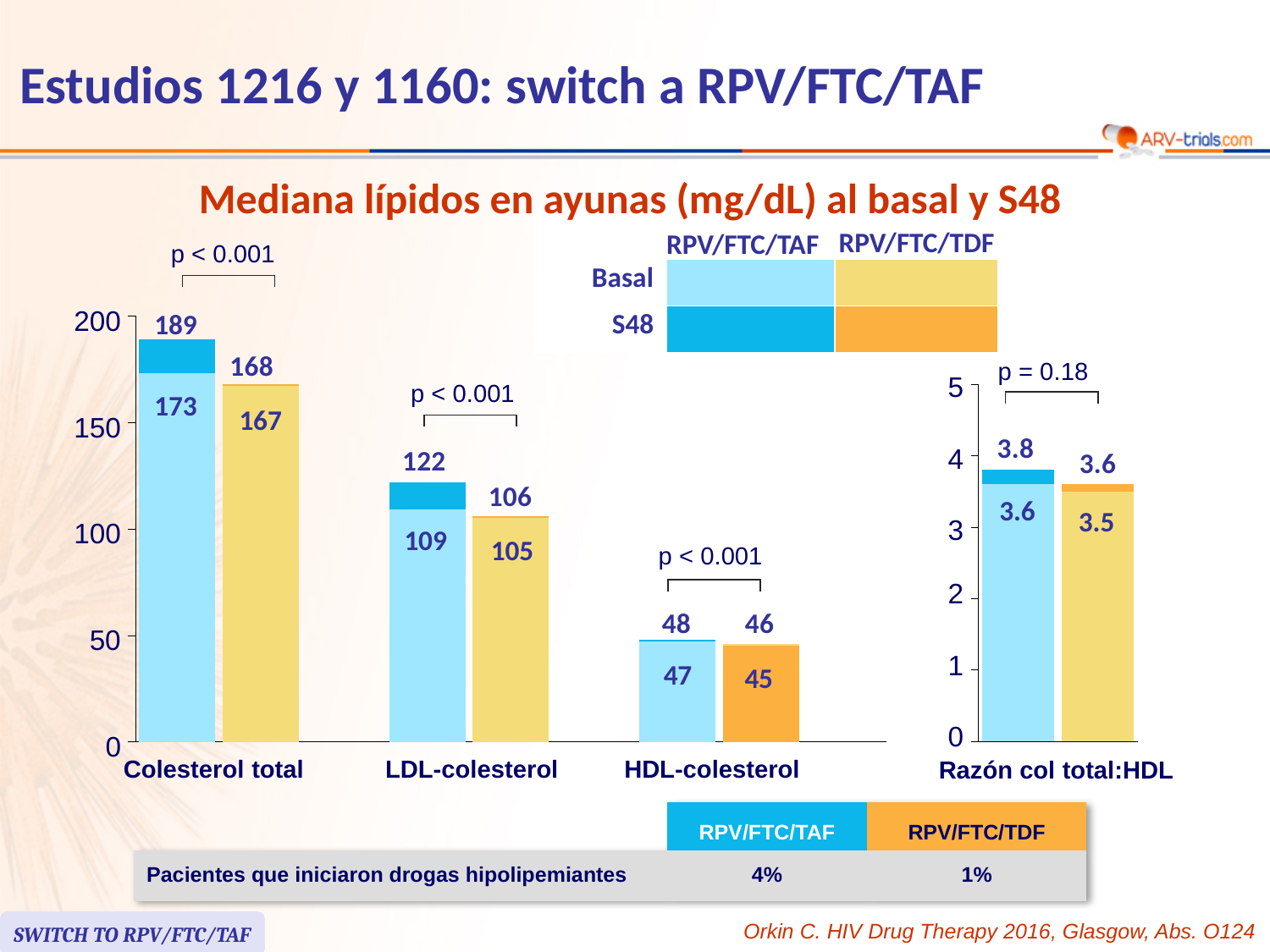
What type of chart is used to display the lipid values on this slide? Bar chart In the left chart, which group has the higher S48 total cholesterol, RPV/FTC/TAF or RPV/FTC/TDF? RPV/FTC/TAF In the left chart, by how much did median total cholesterol change from baseline (173) to S48 (189) in the RPV/FTC/TAF group? 16 In the left chart, how many lipid parameters (categories) are shown on the x axis? 3 In the left chart, which lipid parameter has the lowest values? HDL-colesterol In the left chart, what is the baseline (Basal) median total cholesterol for the RPV/FTC/TDF group? 167 In the left chart, what is the S48 median LDL-colesterol value for the RPV/FTC/TAF group? 122 In the left chart, what is the baseline (Basal) median HDL-colesterol value for the RPV/FTC/TDF group? 45 In the right chart (Razón col total:HDL), what is the S48 value for the RPV/FTC/TAF group? 3.8 In the left chart, what is the difference between the S48 LDL-colesterol values of the RPV/FTC/TAF group (122) and the RPV/FTC/TDF group (106)? 16 In the left chart, what is the S48 median total cholesterol (Colesterol total) for the RPV/FTC/TAF group? 189 What p-value is shown above the Razón col total:HDL comparison in the right chart? p = 0.18